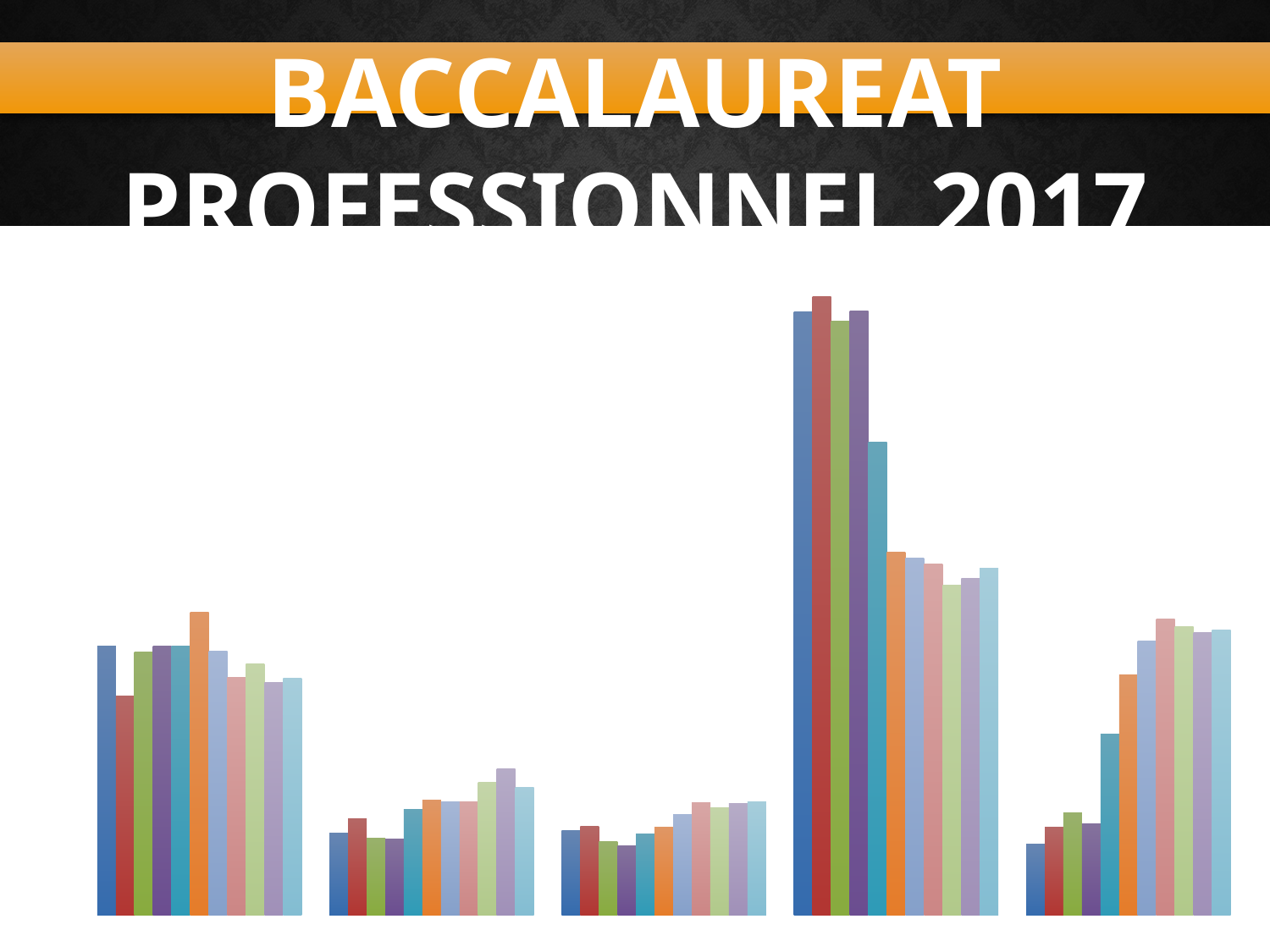
Are the bars in the fourth group from the left taller or shorter than the bars in the first group? taller What kind of chart is shown on the slide? bar chart Within the fourth group from the left, do the bars generally rise or fall from left to right? fall Does the chart show any axis labels or data labels? No How many groups of bars does the chart contain? 5 How many bars are there in each group of the chart? 11 Which group of bars, counting from the left, contains the tallest bars on the chart? the fourth group Within the rightmost group, do the bars generally rise or fall from left to right? rise Does the chart display a legend? No Within the second group from the left, do the bars generally rise or fall from left to right? rise